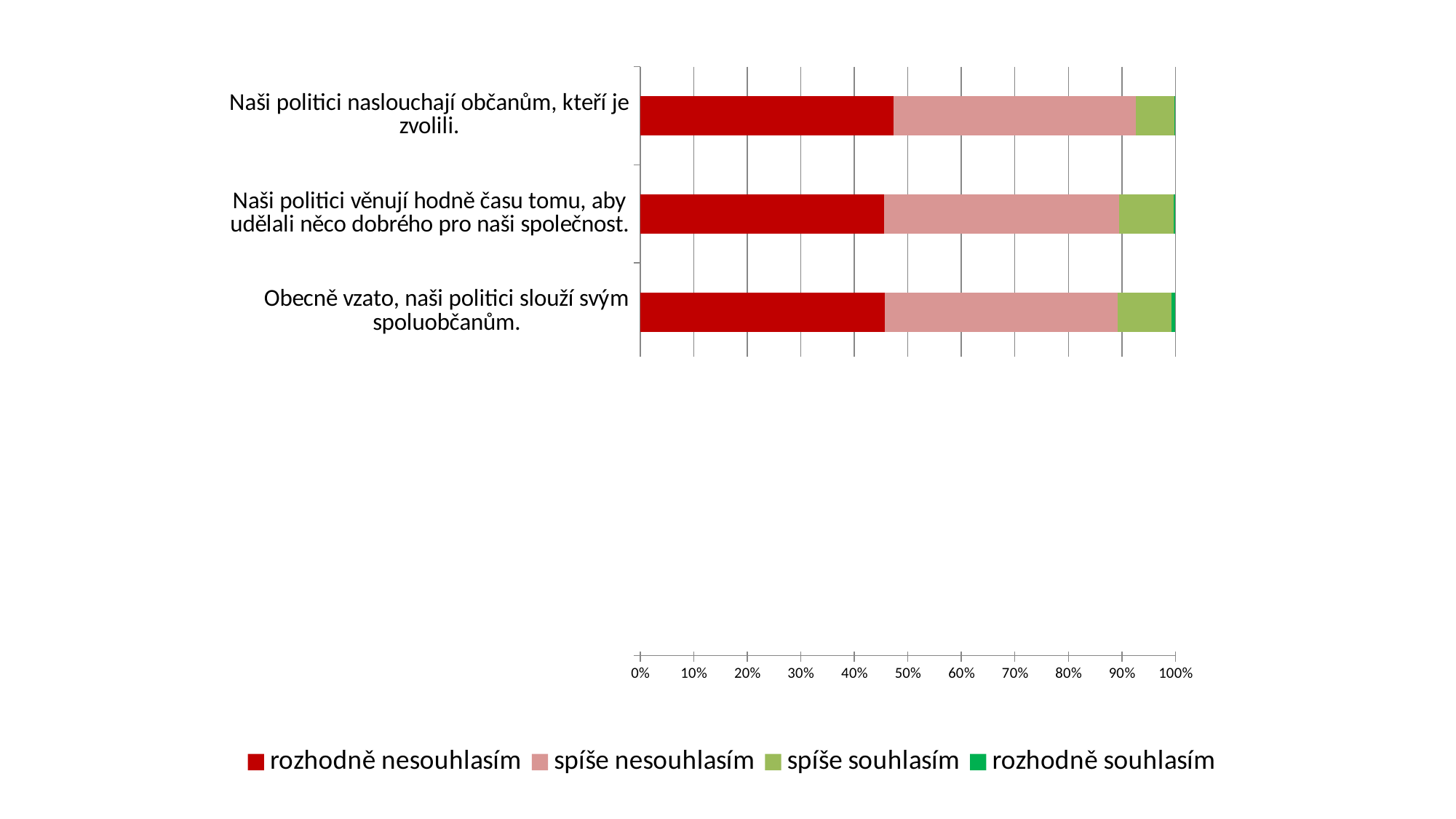
What is the last entry in the chart legend? rozhodně souhlasím Is the 'rozhodně nesouhlasím' value for 'Naši politici věnují hodně času tomu, aby udělali něco dobrého pro naši společnost.' greater or less than 50%? less What is the highest value shown on the horizontal axis? 100% How many statements (categories) are plotted on the chart? 3 Is the 'rozhodně nesouhlasím' value for 'Naši politici naslouchají občanům, kteří je zvolili.' greater or less than 50%? less Which series is shown in dark red in the legend? rozhodně nesouhlasím Is the 'rozhodně nesouhlasím' value for 'Naši politici naslouchají občanům, kteří je zvolili.' greater or less than 40%? greater What kind of chart is shown on the slide? stacked bar chart How many series does the legend list? 4